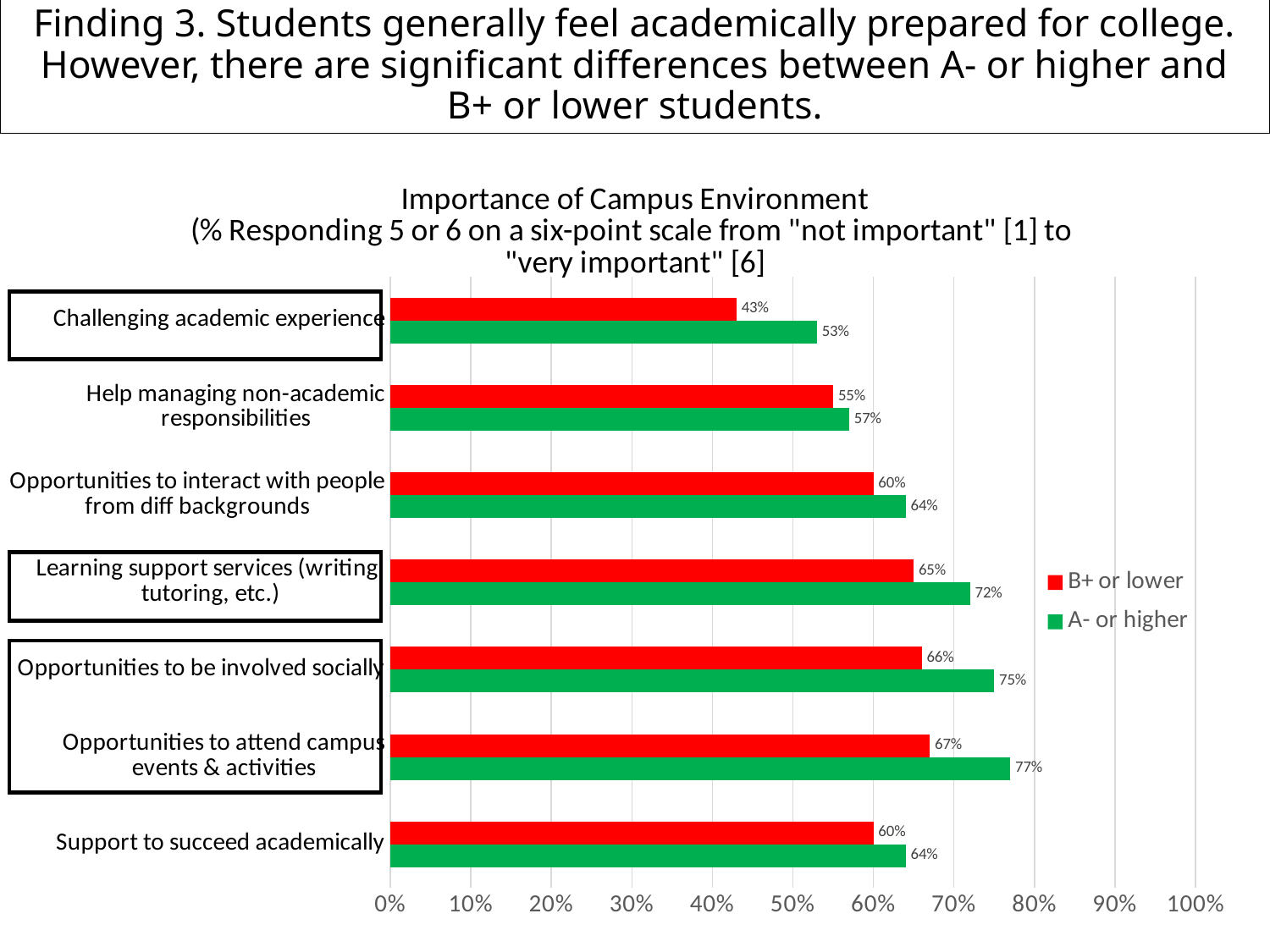
What is the difference between A- or higher and B+ or lower students for 'Opportunities to be involved socially'? 9% Which category has the highest value for A- or higher students? Opportunities to attend campus events & activities What is the difference between A- or higher and B+ or lower students for 'Challenging academic experience'? 10% What percentage of A- or higher students rated 'Opportunities to attend campus events & activities' as important? 77% Which colour represents the 'A- or higher' series? Green How many series does the legend list? 2 What kind of chart is shown on the slide? Bar chart Which category has the lowest value for B+ or lower students? Challenging academic experience How many categories are shown on the chart? 7 What percentage of B+ or lower students rated 'Challenging academic experience' as important? 43% Which group has the larger value for 'Learning support services (writing tutoring, etc.)': B+ or lower or A- or higher? A- or higher What is the value for B+ or lower students on 'Learning support services (writing tutoring, etc.)'? 65%